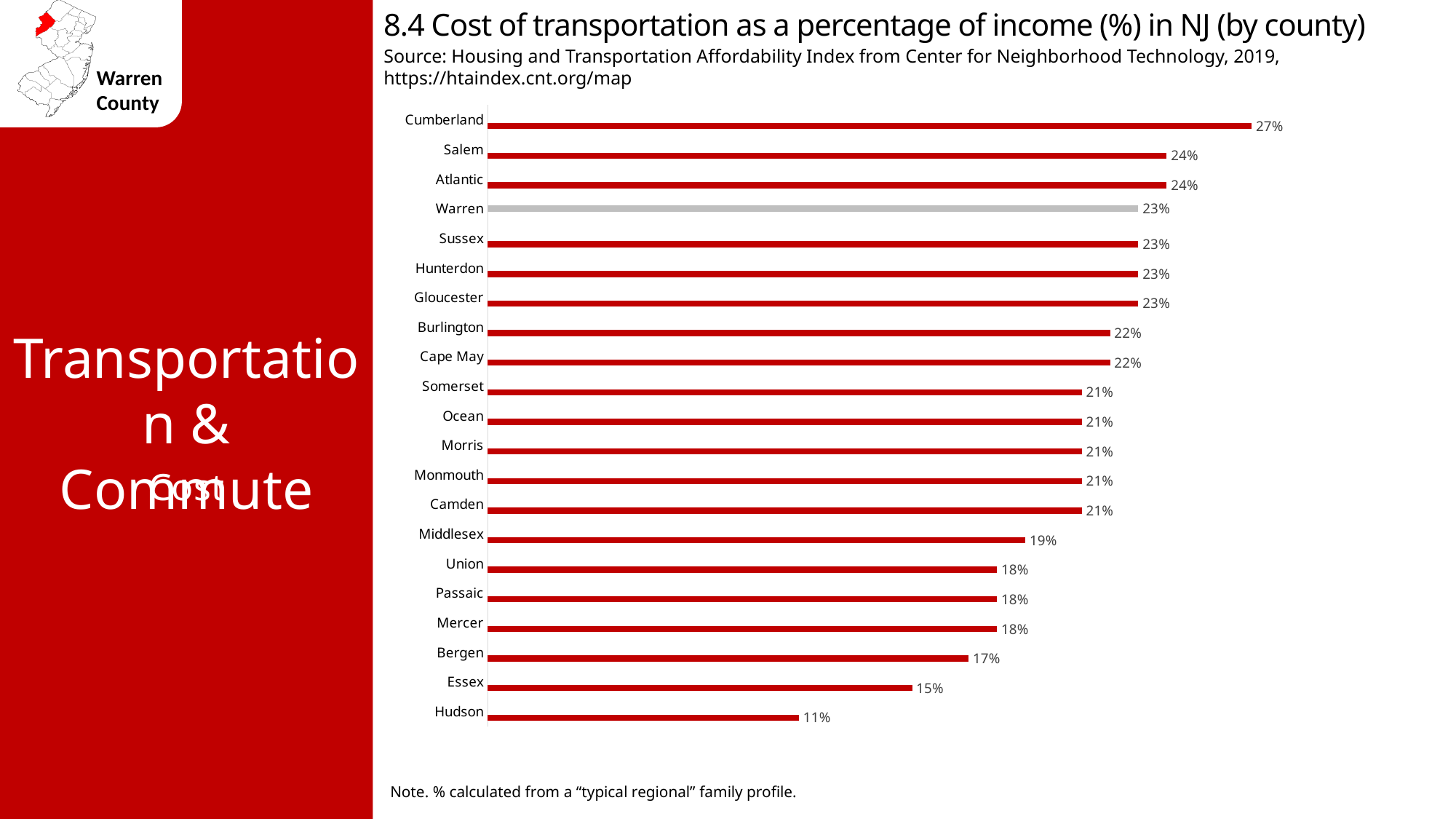
What is the cost of transportation as a percentage of income for Warren county? 23% What is the difference between the values for Cumberland and Hudson? 16% Which county has the lowest cost of transportation as a percentage of income? Hudson What is the value shown for Middlesex county? 19% Which county has a larger value, Bergen or Essex? Bergen What is the cost of transportation as a percentage of income for Hudson county? 11% How many counties are shown in the chart? 21 Which county's bar is shown in grey rather than red? Warren What kind of chart is shown on the slide? Bar chart Which county has a larger value, Cumberland or Salem? Cumberland What is the difference between the values for Salem and Essex? 9% Which county has the highest cost of transportation as a percentage of income? Cumberland